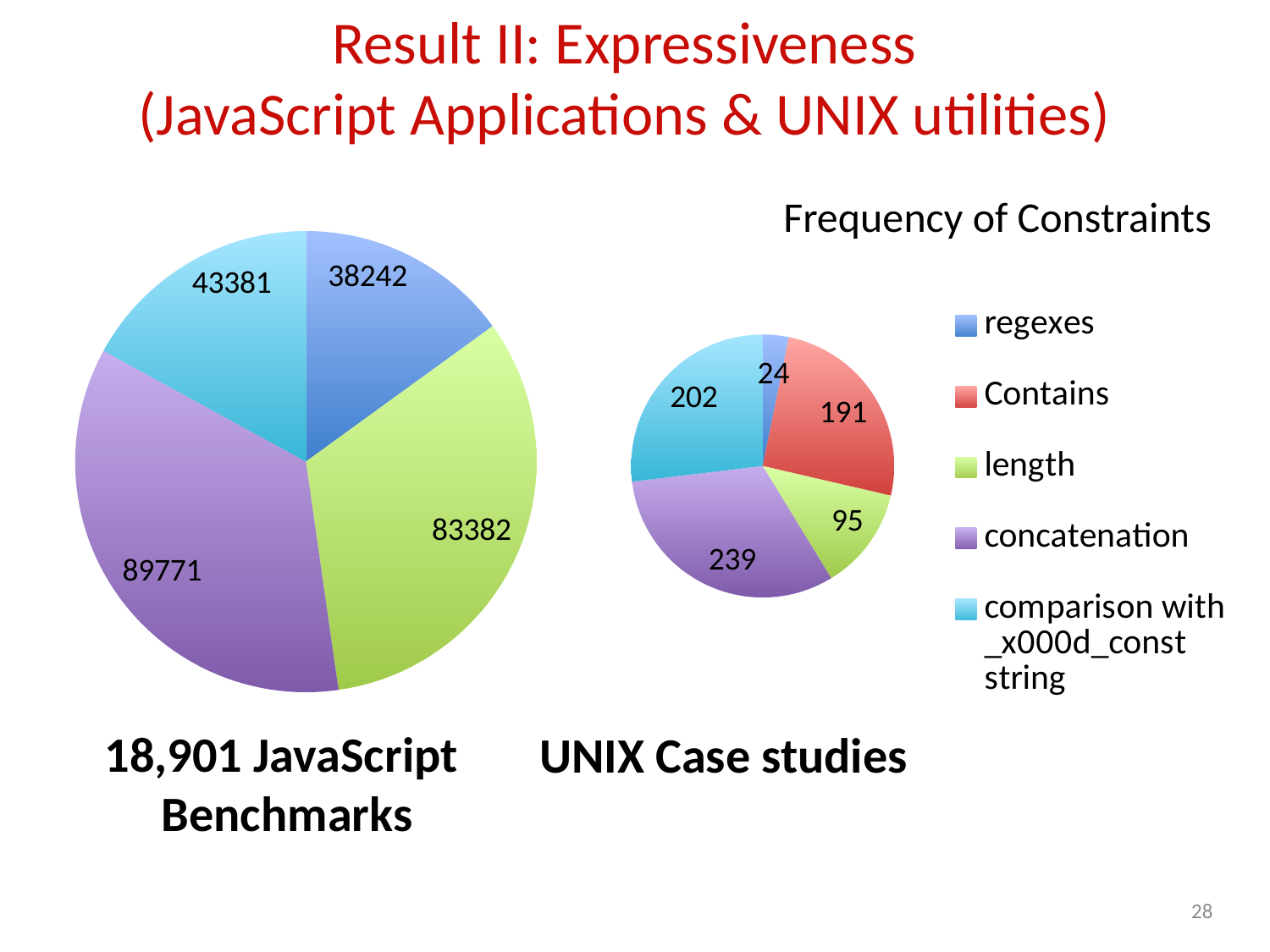
How many slices does the right pie chart (UNIX Case studies) have? 5 What type of chart is used for the JavaScript Benchmarks data? pie chart In the left pie chart (JavaScript Benchmarks), what is the value for concatenation? 89771 In the right pie chart (UNIX Case studies), what is the value for Contains? 191 How many entries does the legend list? 5 In the right pie chart (UNIX Case studies), which is larger: concatenation or comparison with const string? concatenation In the left pie chart (JavaScript Benchmarks), what is the value for regexes? 38242 In the left pie chart (JavaScript Benchmarks), which category has the largest value? concatenation In the right pie chart (UNIX Case studies), which category has the smallest value? regexes In the left pie chart (JavaScript Benchmarks), what is the difference between the concatenation value and the length value? 6389 In the right pie chart (UNIX Case studies), what is the value for length? 95 In the right pie chart (UNIX Case studies), what is the difference between the Contains value and the length value? 96